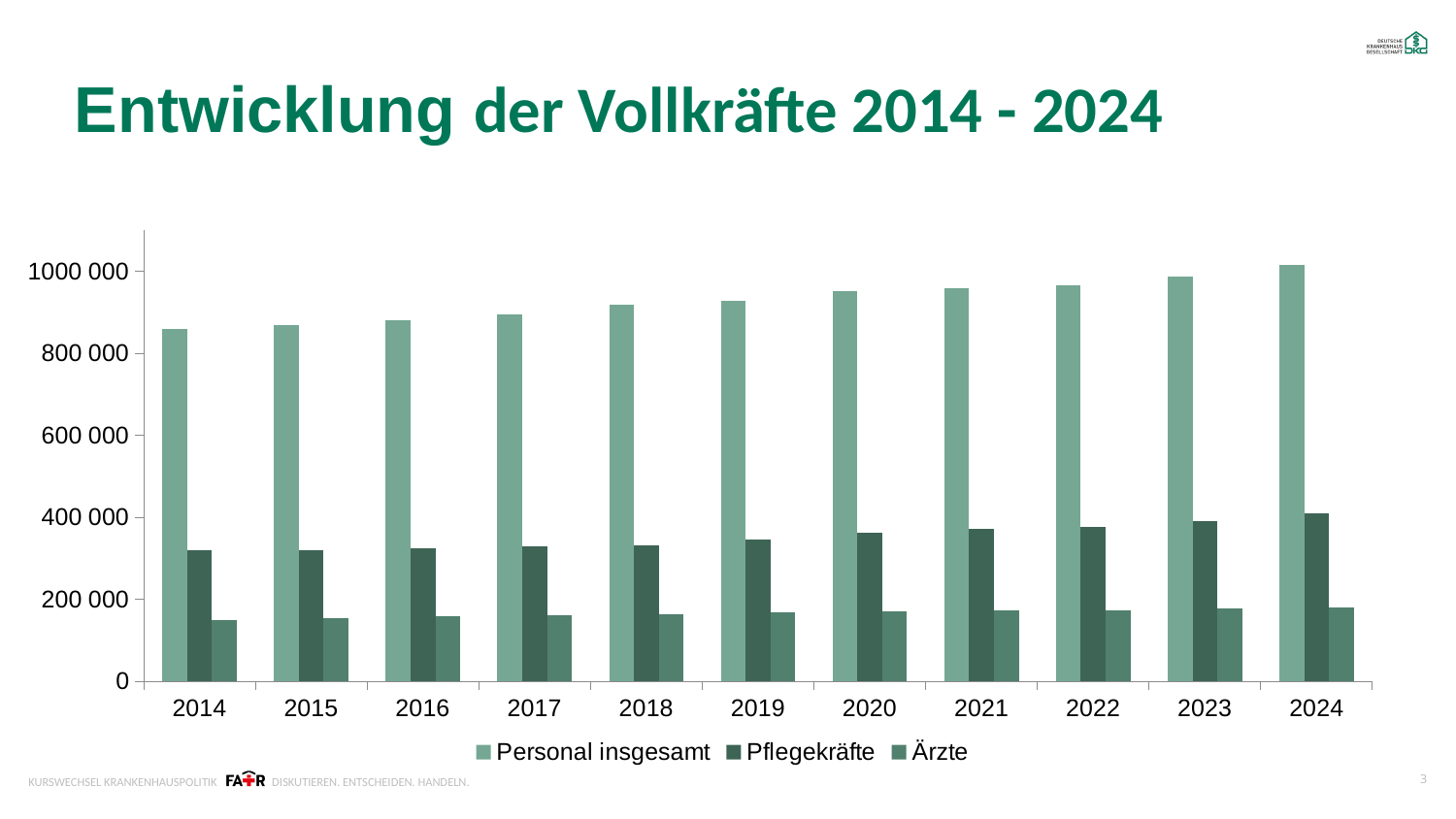
Is the value for Personal insgesamt in 2014 greater or less than 800 000? greater Is the value for Ärzte in 2024 greater or less than 200 000? less Which is larger in 2024, the value for Pflegekräfte or the value for Ärzte? Pflegekräfte Is the value for Pflegekräfte in 2014 greater or less than 400 000? less What kind of chart is shown on the slide? bar chart What is the title of the slide? Entwicklung der Vollkräfte 2014 - 2024 Do the values for Pflegekräfte rise or fall from 2014 to 2024? rise Which series is shown in the lightest green? Personal insgesamt How many years are shown on the x axis? 11 How many series does the legend list? 3 In which year is the value for Personal insgesamt highest? 2024 In which year is the value for Personal insgesamt lowest? 2014